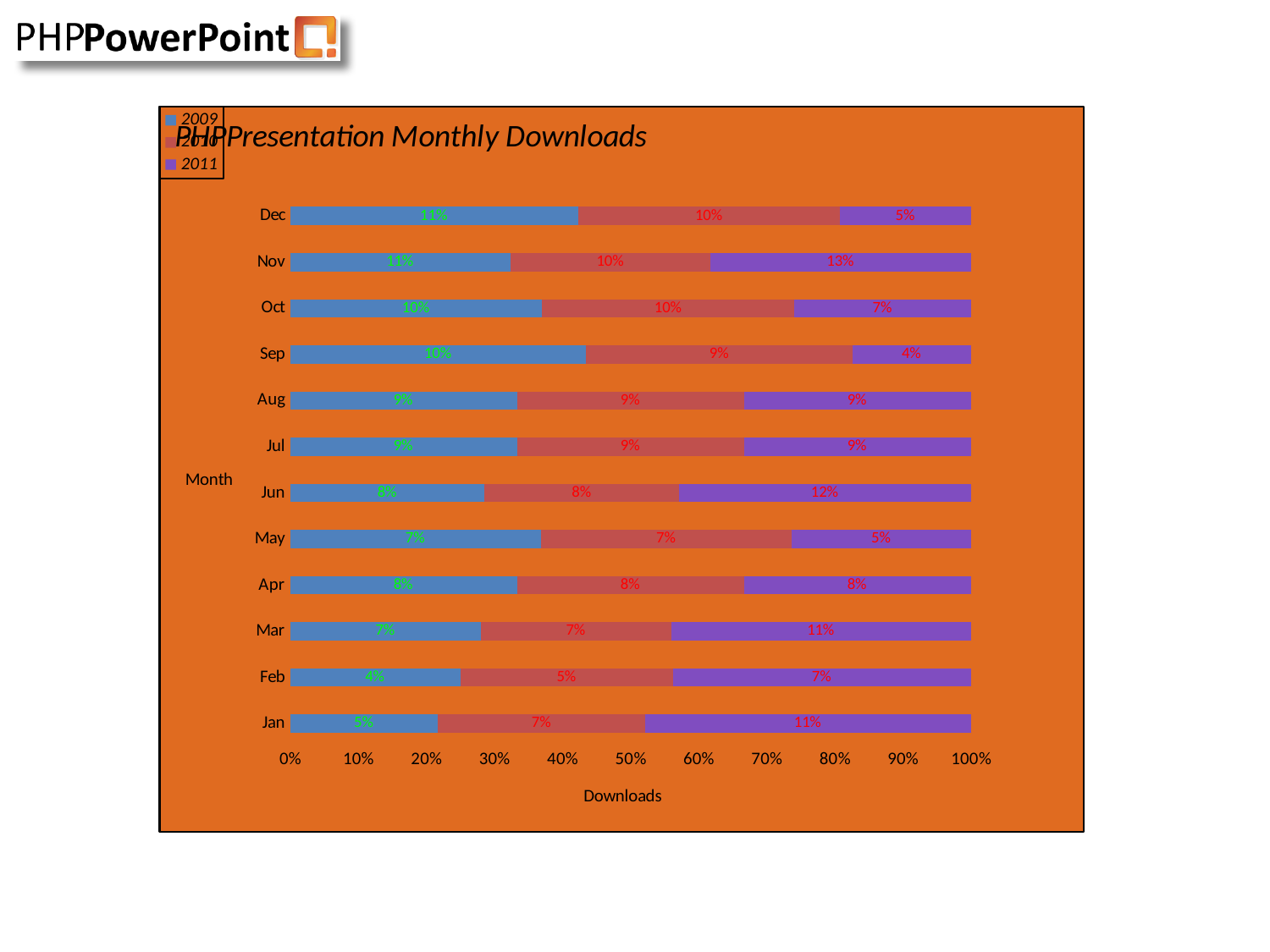
How many series does the legend list? 3 Which month has the highest value for the 2011 series? Nov What is the value for 2010 in Jan? 7% What kind of chart is shown on the slide? Stacked bar chart Which month has the lowest value for the 2009 series? Feb What is the title of the chart? PHPPresentation Monthly Downloads In Jun, which series has the larger value, 2009 or 2011? 2011 What is the value for 2009 in Feb? 4% How many months are shown on the chart? 12 What is the difference between the 2011 values for Nov and Sep? 9% What is the value for 2011 in Sep? 4% What is the value for 2011 in Nov? 13%